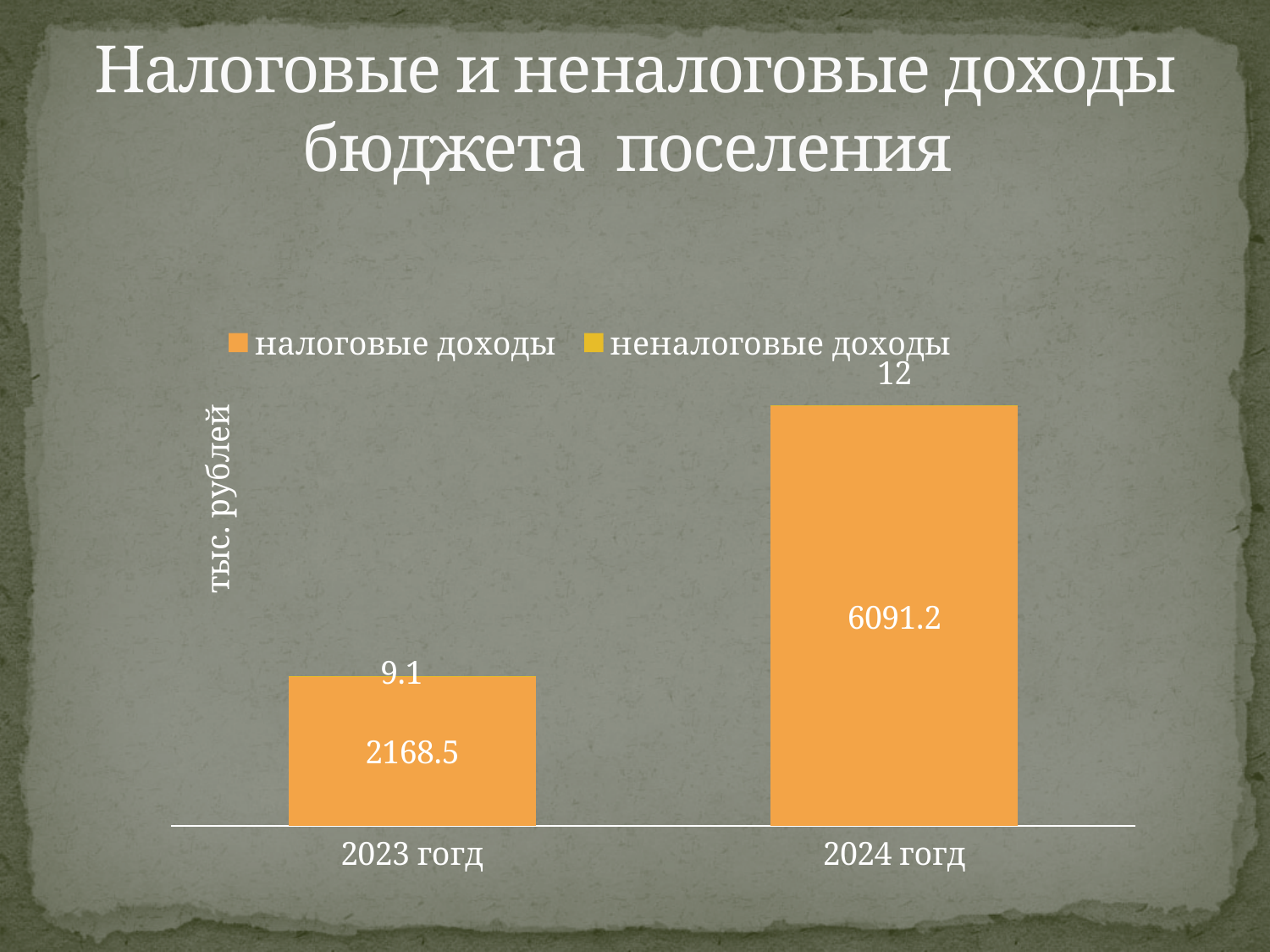
What is the difference in неналоговые доходы between 2024 гогд and 2023 гогд? 2.9 How many series does the legend list? 2 What kind of chart is shown on the slide? Stacked bar chart What is the difference in налоговые доходы between 2024 гогд and 2023 гогд? 3922.7 Which year has the higher value of налоговые доходы? 2024 гогд What is the value of неналоговые доходы for 2024 гогд? 12 What is the value of налоговые доходы for 2024 гогд? 6091.2 What unit is shown on the vertical axis label? тыс. рублей What is the value of налоговые доходы for 2023 гогд? 2168.5 What is the total of the stacked bar for 2024 гогд? 6103.2 What is the value of неналоговые доходы for 2023 гогд? 9.1 Which year has the lower value of неналоговые доходы? 2023 гогд